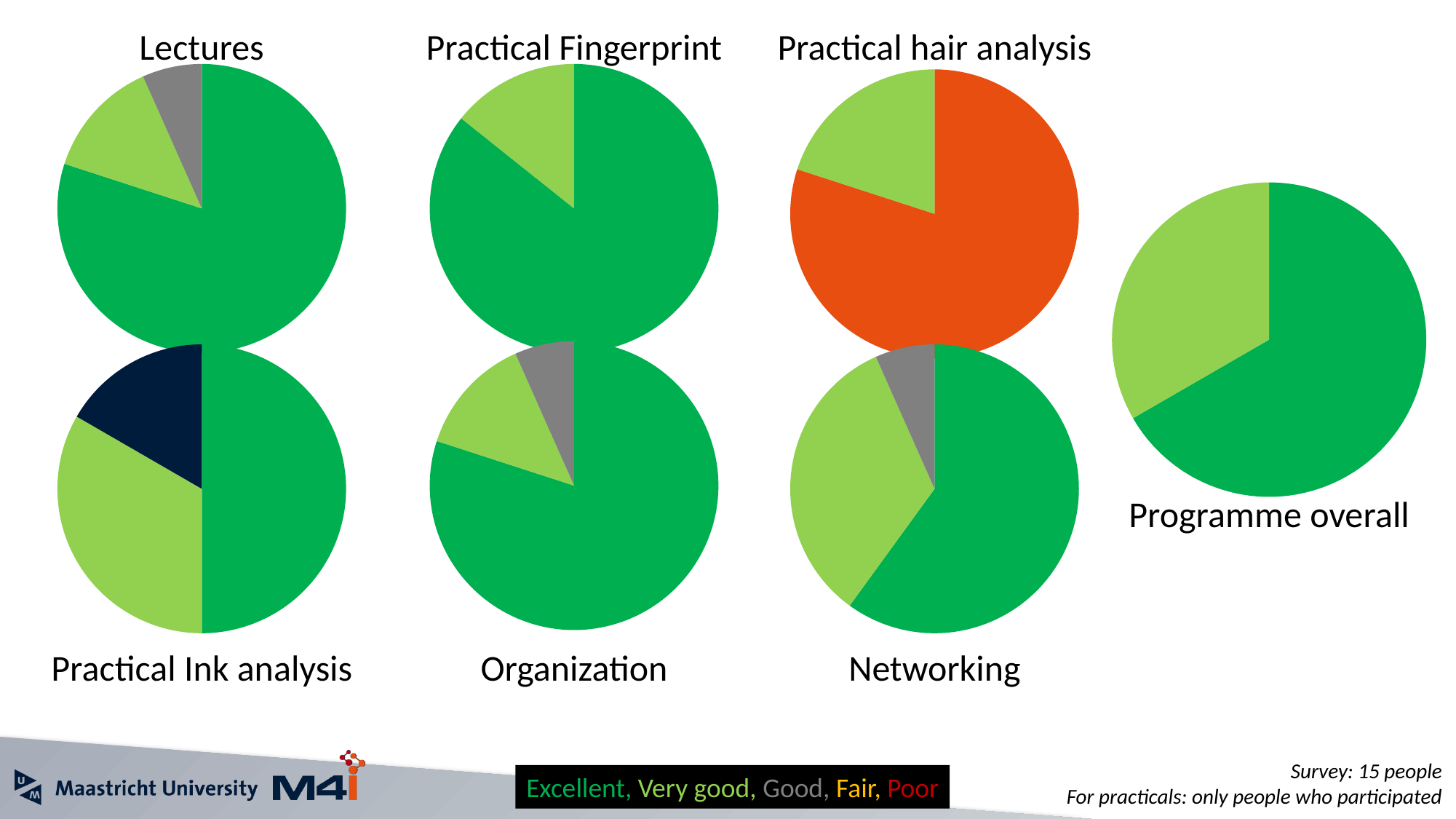
In the "Programme overall" pie chart, how many slices are there? 2 In the "Programme overall" pie chart, which is larger: the Excellent slice or the Very good slice? Excellent In the "Networking" pie chart, which rating category has the smallest slice? Good What kind of chart is used for the "Lectures" rating? Pie chart In the "Practical Fingerprint" pie chart, which rating category has the largest slice? Excellent How many pie charts are shown on the slide? 7 According to the note on the slide, how many people took part in the survey? 15 people In the "Lectures" pie chart, which rating category has the largest slice? Excellent How many rating categories does the legend at the bottom of the slide list? 5 In the "Organization" pie chart, which rating category has the smallest slice? Good In the "Lectures" pie chart, which is larger: the Very good slice or the Good slice? Very good In the "Practical Fingerprint" pie chart, how many slices are there? 2